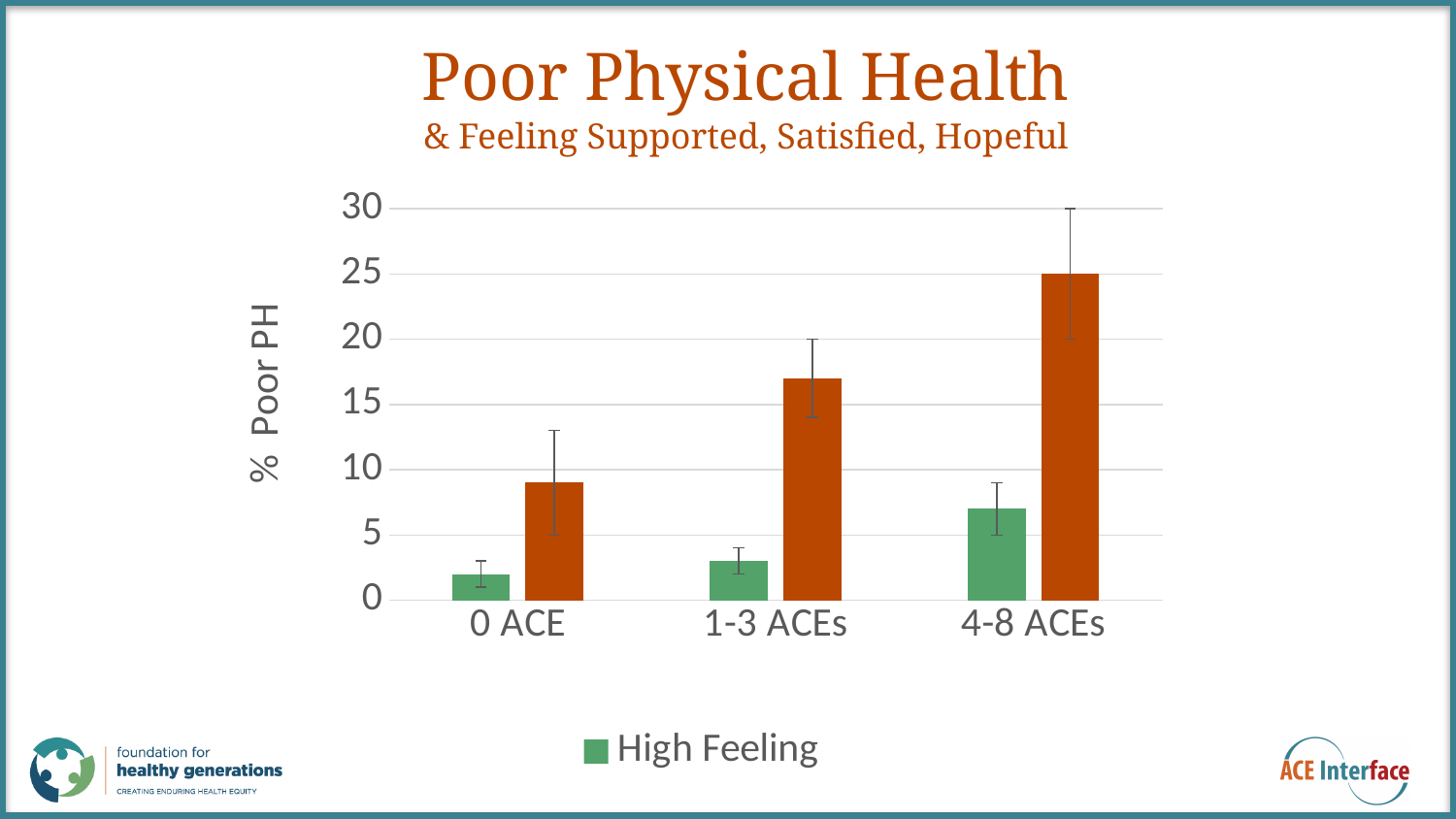
Is the value of the orange bar for 0 ACE greater or less than 10? less How many categories are shown on the x axis? 3 What is the label on the y axis? % Poor PH How many series does the legend list? 1 Which category has the lowest High Feeling bar? 0 ACE Is the value of the orange bar for 1-3 ACEs greater or less than 15? greater What kind of chart is shown on the slide? bar chart Is the value of the High Feeling bar for 0 ACE greater or less than 5? less Which category has the highest orange bar? 4-8 ACEs What is the label of the series shown in the legend? High Feeling Do the orange bars rise or fall from 0 ACE to 4-8 ACEs? rise